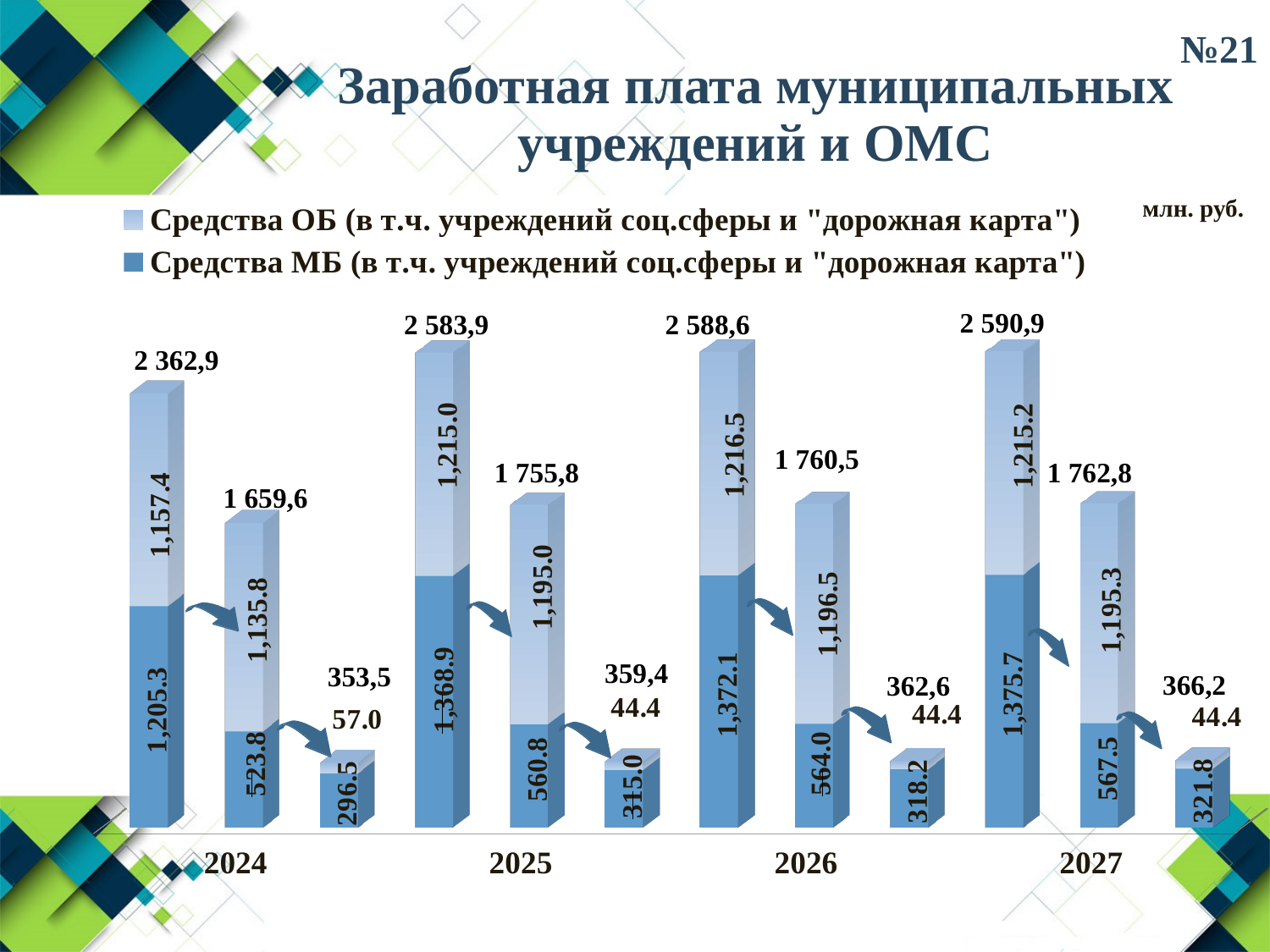
In which year is the total of the tallest bar the lowest? 2024 Do the totals of the smallest bars rise or fall from 2024 to 2027? rise What is the difference between the tallest-bar totals for 2027 (2 590,9) and 2024 (2 362,9)? 228,0 What is the value of the Средства МБ segment in the tallest bar for 2025? 1,368.9 How many years are shown along the x axis? 4 In the tallest bar for 2024, which segment is larger: Средства ОБ or Средства МБ? Средства МБ How many series does the legend list? 2 What is the value of the Средства ОБ segment in the tallest bar for 2027? 1,215.2 What is the total printed above the tallest bar for 2024? 2 362,9 In which year is the total of the tallest bar the highest? 2027 What kind of chart is shown on the slide? stacked bar chart What is the total printed above the smallest bar for 2026? 362,6